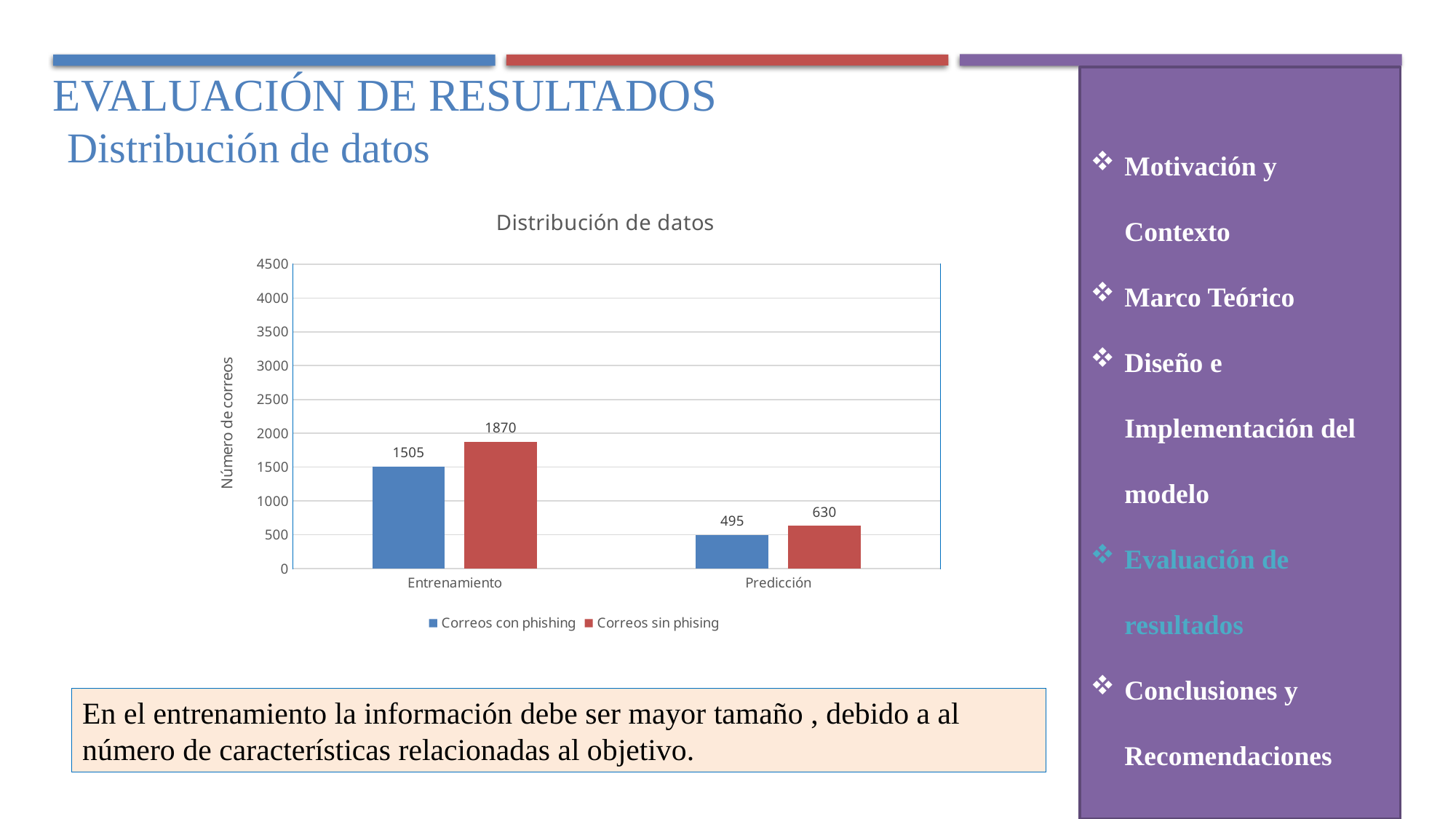
What is the difference between Correos sin phising and Correos con phishing in the Predicción category? 135 What kind of chart is shown on the slide? Bar chart How many categories are shown on the x axis? 2 Which is larger in the Predicción category: Correos con phishing or Correos sin phising? Correos sin phising Which category has the highest value for Correos sin phising? Entrenamiento What is the value for Correos con phishing in the Entrenamiento category? 1505 What is the value for Correos con phishing in the Predicción category? 495 What is the difference between Correos sin phising and Correos con phishing in the Entrenamiento category? 365 What is the value for Correos sin phising in the Entrenamiento category? 1870 How many series does the legend list? 2 What is the value for Correos sin phising in the Predicción category? 630 Which category has the lowest value for Correos con phishing? Predicción